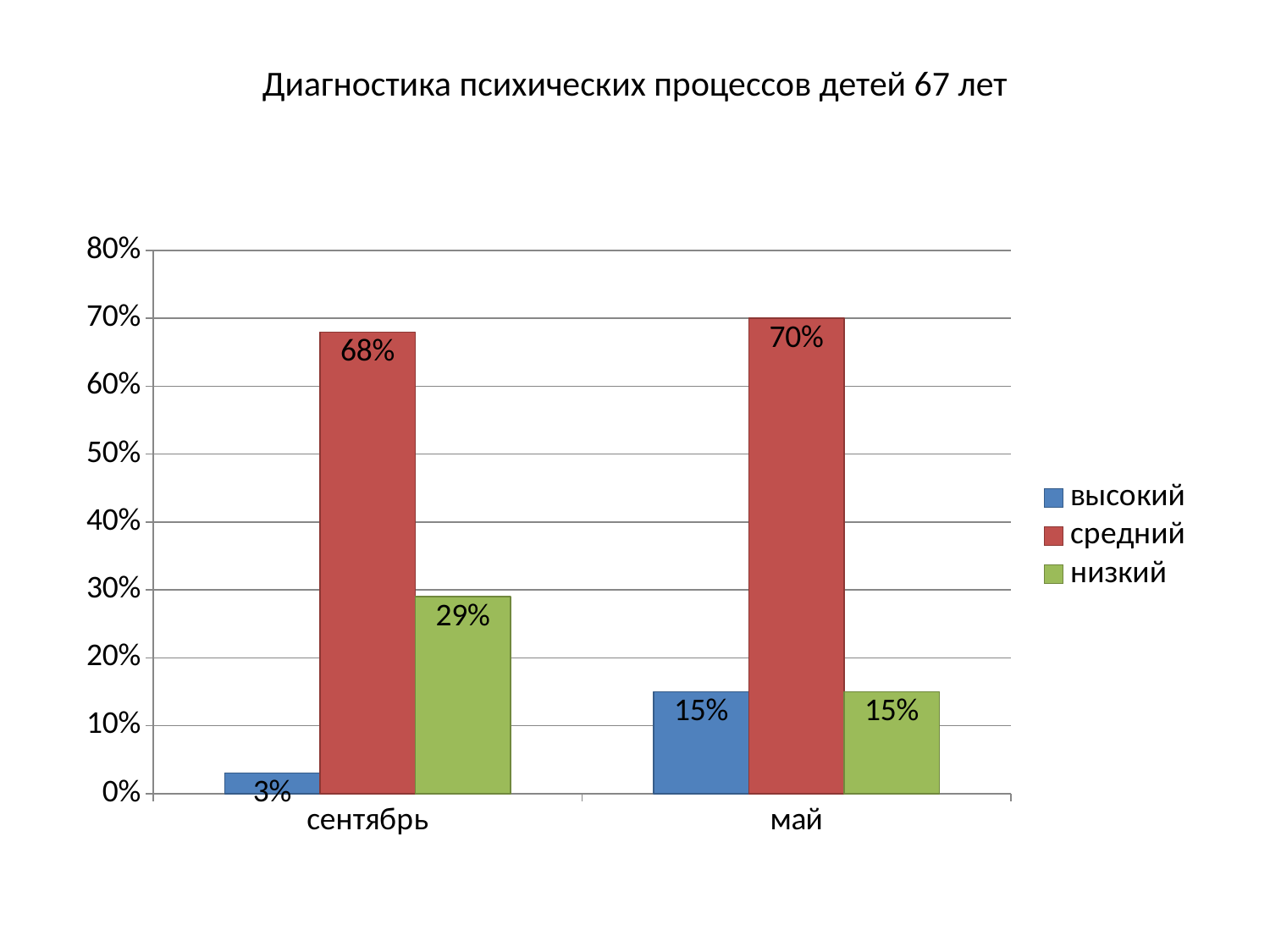
Which series has the lowest value in сентябрь? высокий What is the value for высокий in май? 15% Which is larger: высокий in сентябрь or высокий in май? высокий in май What kind of chart is shown on the slide? bar chart What is the difference between the средний values in май and сентябрь? 2% Which series has the highest value in сентябрь? средний What is the difference between the низкий values in сентябрь and май? 14% What is the value for низкий in сентябрь? 29% What is the value for высокий in сентябрь? 3% How many categories are shown on the x axis? 2 What is the value for средний in май? 70% How many series does the legend list? 3